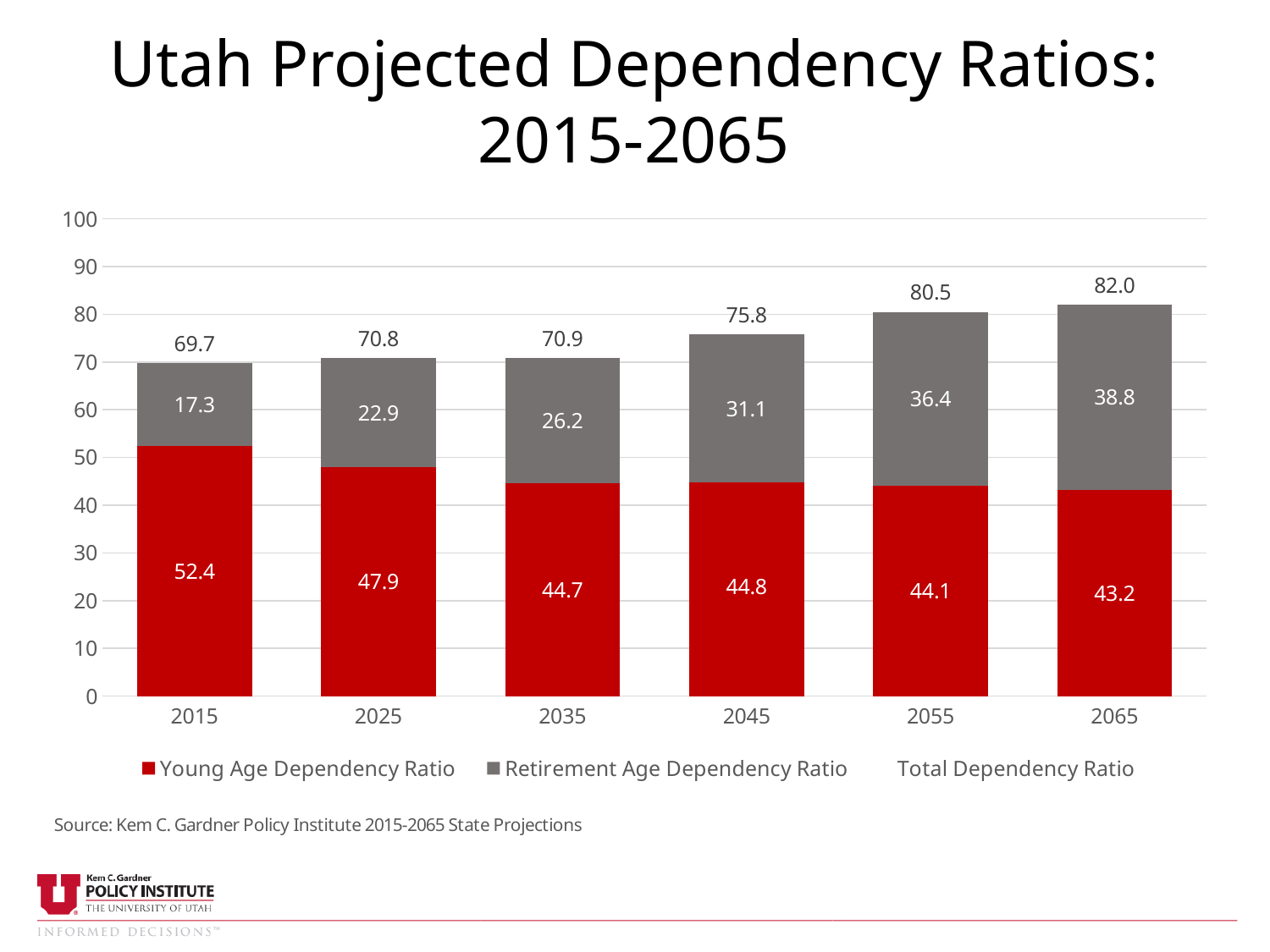
Does the Retirement Age Dependency Ratio rise or fall from 2015 to 2065? Rise Which year has the highest Retirement Age Dependency Ratio? 2065 What is the Retirement Age Dependency Ratio for 2045? 31.1 What kind of chart is shown? Stacked bar chart What colour represents the Young Age Dependency Ratio? Red What is the Young Age Dependency Ratio for 2015? 52.4 How many years are shown on the x axis? 6 What is the Total Dependency Ratio for 2055? 80.5 Which year has the lowest Young Age Dependency Ratio? 2065 How many entries does the legend list? 3 Which is larger, the Young Age Dependency Ratio in 2025 or the Retirement Age Dependency Ratio in 2065? Young Age Dependency Ratio in 2025 What is the difference between the Total Dependency Ratio in 2065 and in 2015? 12.3